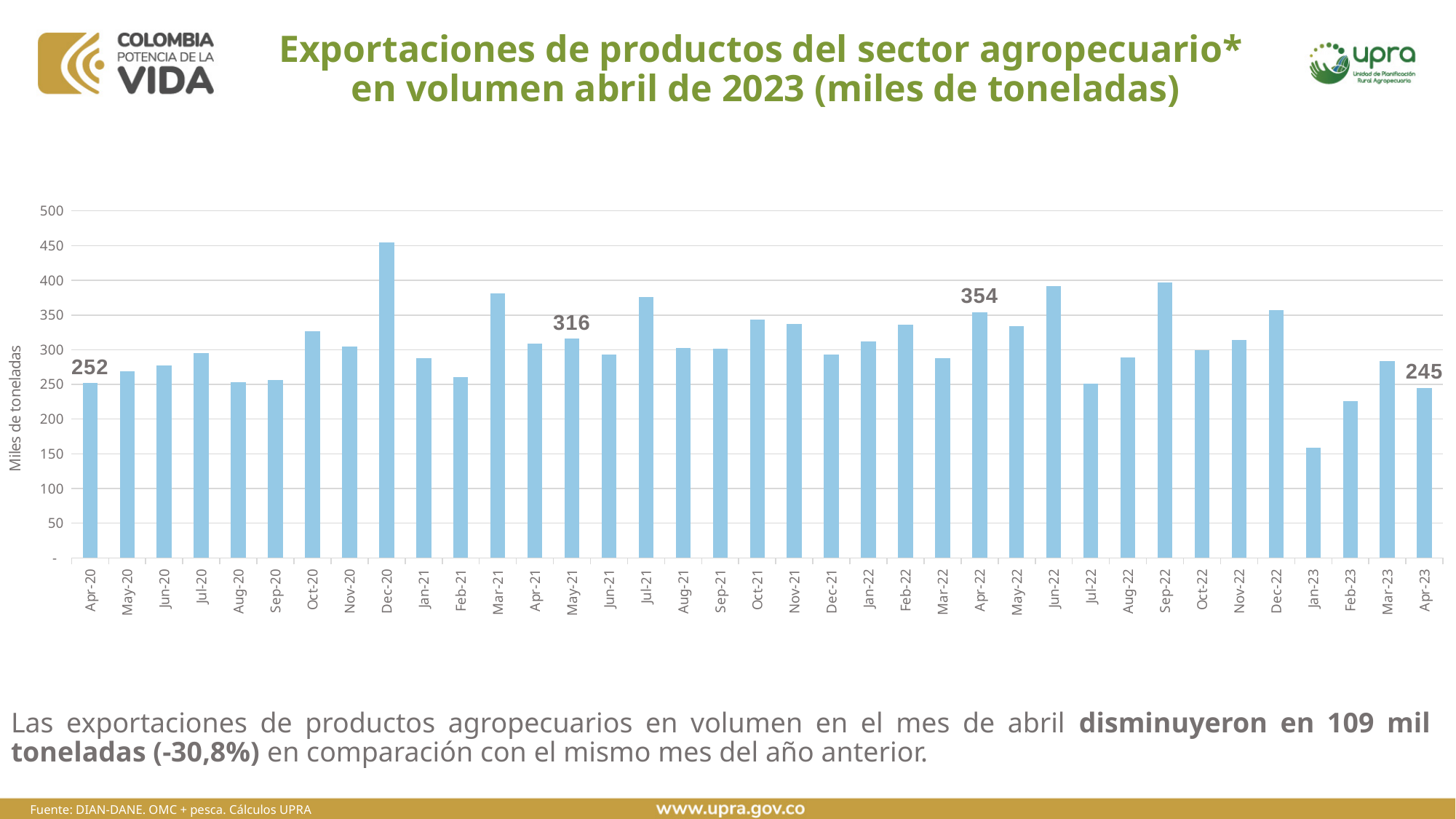
How many monthly bars are plotted in the chart? 37 What is the value for Apr-22? 354 Is the value for Dec-20 greater or less than 400? greater Which month has the lowest bar? Jan-23 Which month has the highest bar? Dec-20 What is the value for Apr-20? 252 Which is larger, the value for Apr-20 or the value for Apr-23? Apr-20 What kind of chart is shown on the slide? bar chart What is the value for May-21? 316 What is the difference between the values for Apr-22 and Apr-23? 109 What is the value for Apr-23? 245 Is the value for Jan-23 greater or less than 200? less